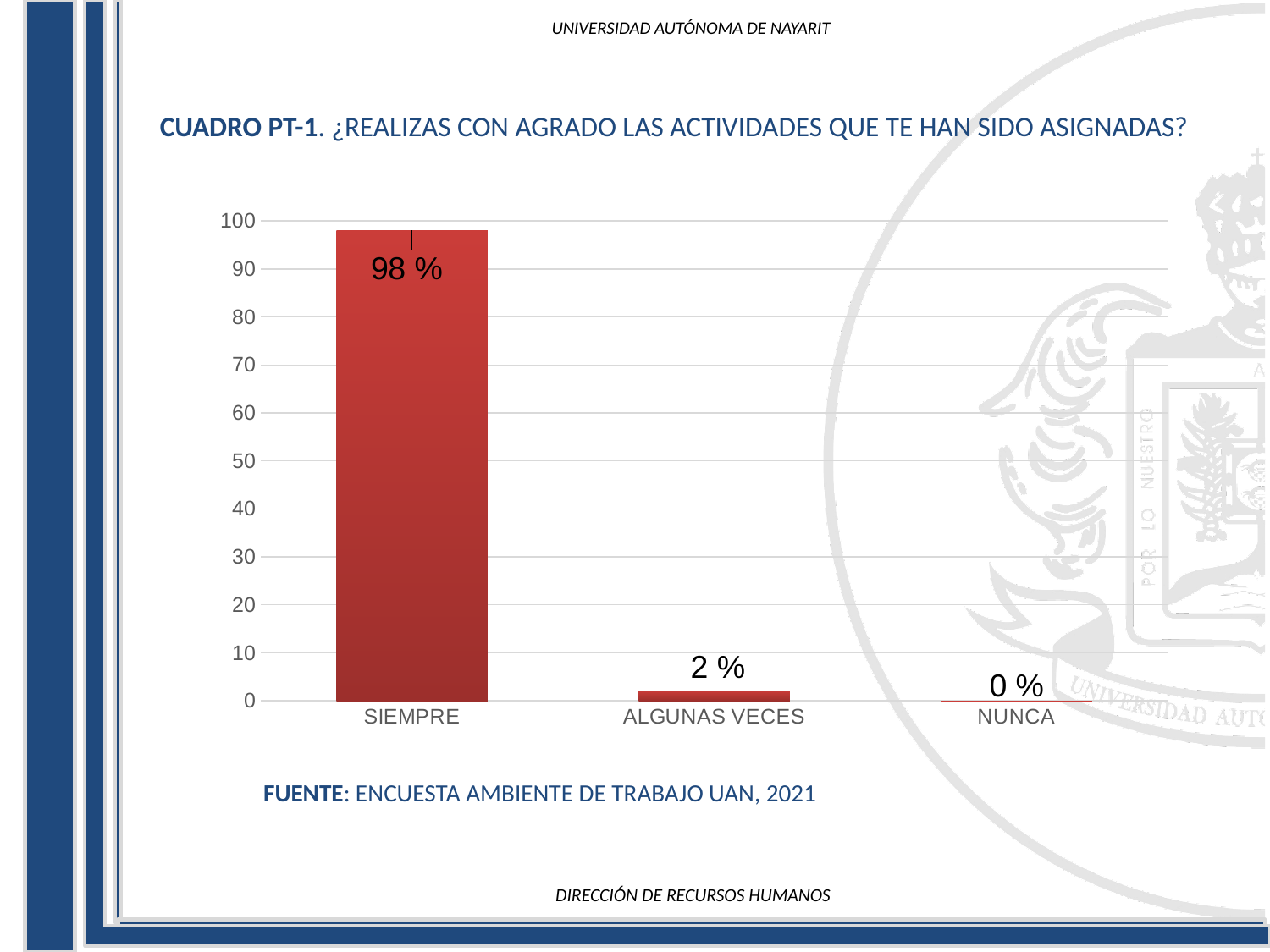
Is the value for SIEMPRE greater or less than 90? greater Which category has the highest value? SIEMPRE What is the value for NUNCA? 0 % What is the difference between the values for SIEMPRE and ALGUNAS VECES? 96 % What is the value for ALGUNAS VECES? 2 % Is the value for ALGUNAS VECES greater or less than 10? less What source is cited below the chart? ENCUESTA AMBIENTE DE TRABAJO UAN, 2021 Which category has the lowest value? NUNCA What is the value for SIEMPRE? 98 % Which is larger, the value for ALGUNAS VECES or the value for NUNCA? ALGUNAS VECES What kind of chart is shown on the slide? bar chart How many categories are shown on the x axis? 3